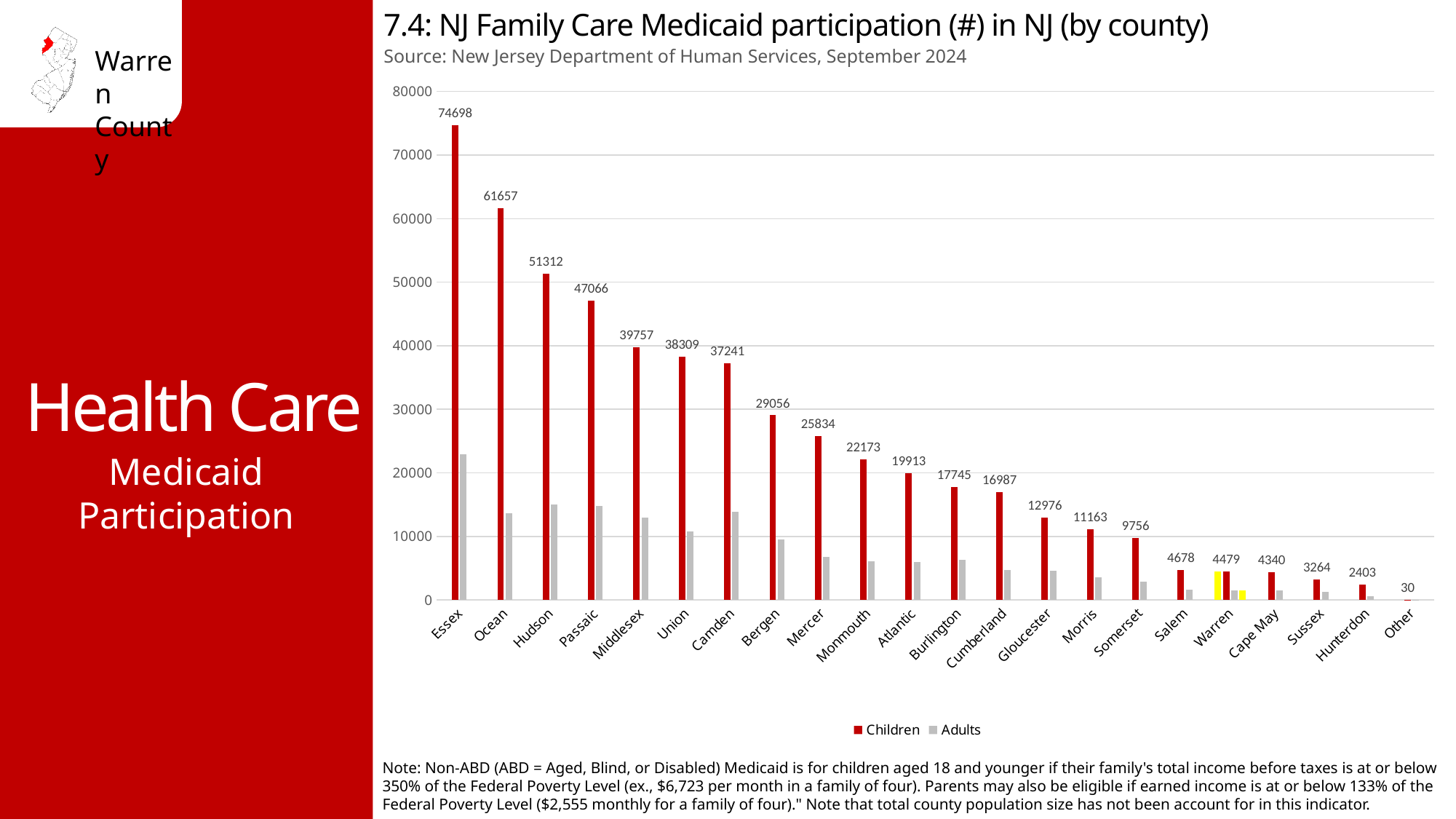
How many series does the legend list? 2 Which has a larger Children value, Bergen or Mercer? Bergen What is the Children value for Warren? 4479 What kind of chart is shown on the slide? Bar chart Is the Adults value for Ocean greater or less than 20000? less Is the Adults value for Essex greater or less than 20000? greater What is the Children value for Monmouth? 22173 Which category has the lowest Children value? Other Which county has the highest Children value? Essex How many categories are shown on the x axis? 22 What is the difference between the Children values for Ocean and Hudson? 10345 What is the Children value for Essex? 74698